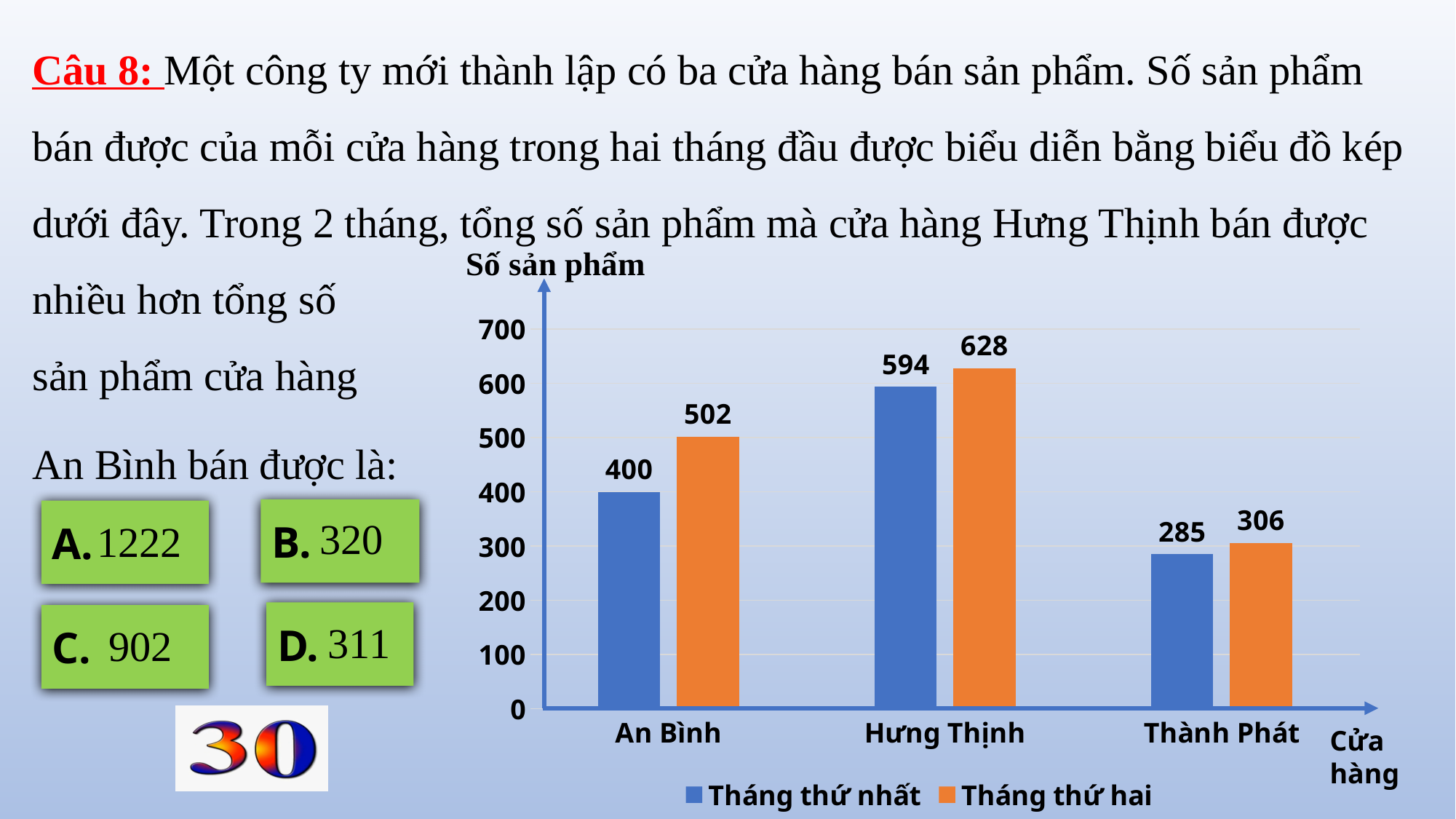
Which store has the highest value in Tháng thứ hai? Hưng Thịnh What is the value for An Bình in Tháng thứ nhất? 400 How many series does the legend list? 2 Which is larger: the Tháng thứ hai value for An Bình or the Tháng thứ nhất value for Hưng Thịnh? Tháng thứ nhất value for Hưng Thịnh What is the value for Hưng Thịnh in Tháng thứ hai? 628 What is the value for Thành Phát in Tháng thứ nhất? 285 How many stores are shown on the x axis? 3 What is the difference between the Tháng thứ hai and Tháng thứ nhất values for An Bình? 102 Which store has the lowest value in Tháng thứ nhất? Thành Phát What is the difference between the Tháng thứ nhất values for Hưng Thịnh and Thành Phát? 309 What is the label of the vertical axis? Số sản phẩm What kind of chart is shown on the slide? Bar chart